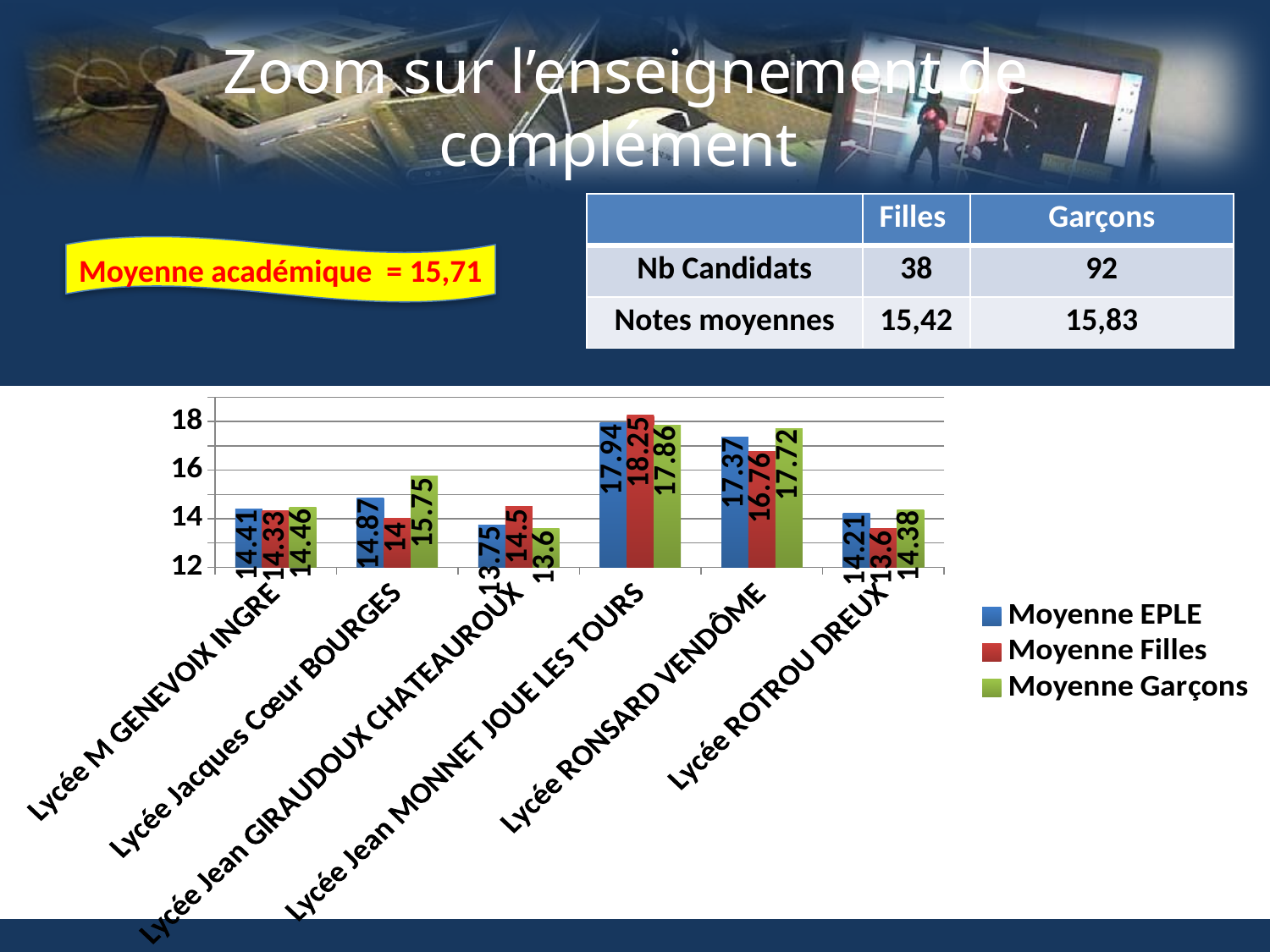
What is the Moyenne EPLE value for Lycée RONSARD VENDÔME? 17.37 For Lycée Jean GIRAUDOUX CHATEAUROUX, which is larger: Moyenne Filles or Moyenne Garçons? Moyenne Filles What is the difference between the Moyenne Garçons and Moyenne Filles values for Lycée Jacques Cœur BOURGES? 1.75 Which lycée has the lowest Moyenne Filles value? Lycée ROTROU DREUX Is the Moyenne Garçons value for Lycée RONSARD VENDÔME greater or less than 16? greater What is the Moyenne Garçons value for Lycée Jacques Cœur BOURGES? 15.75 What is the Moyenne Filles value for Lycée Jean MONNET JOUE LES TOURS? 18.25 How many series does the chart legend list? 3 Which lycée has the highest Moyenne EPLE value? Lycée Jean MONNET JOUE LES TOURS How many lycées (categories) are shown on the x axis of the chart? 6 What colour are the Moyenne Garçons bars in the chart? green What type of chart is shown on the slide? bar chart